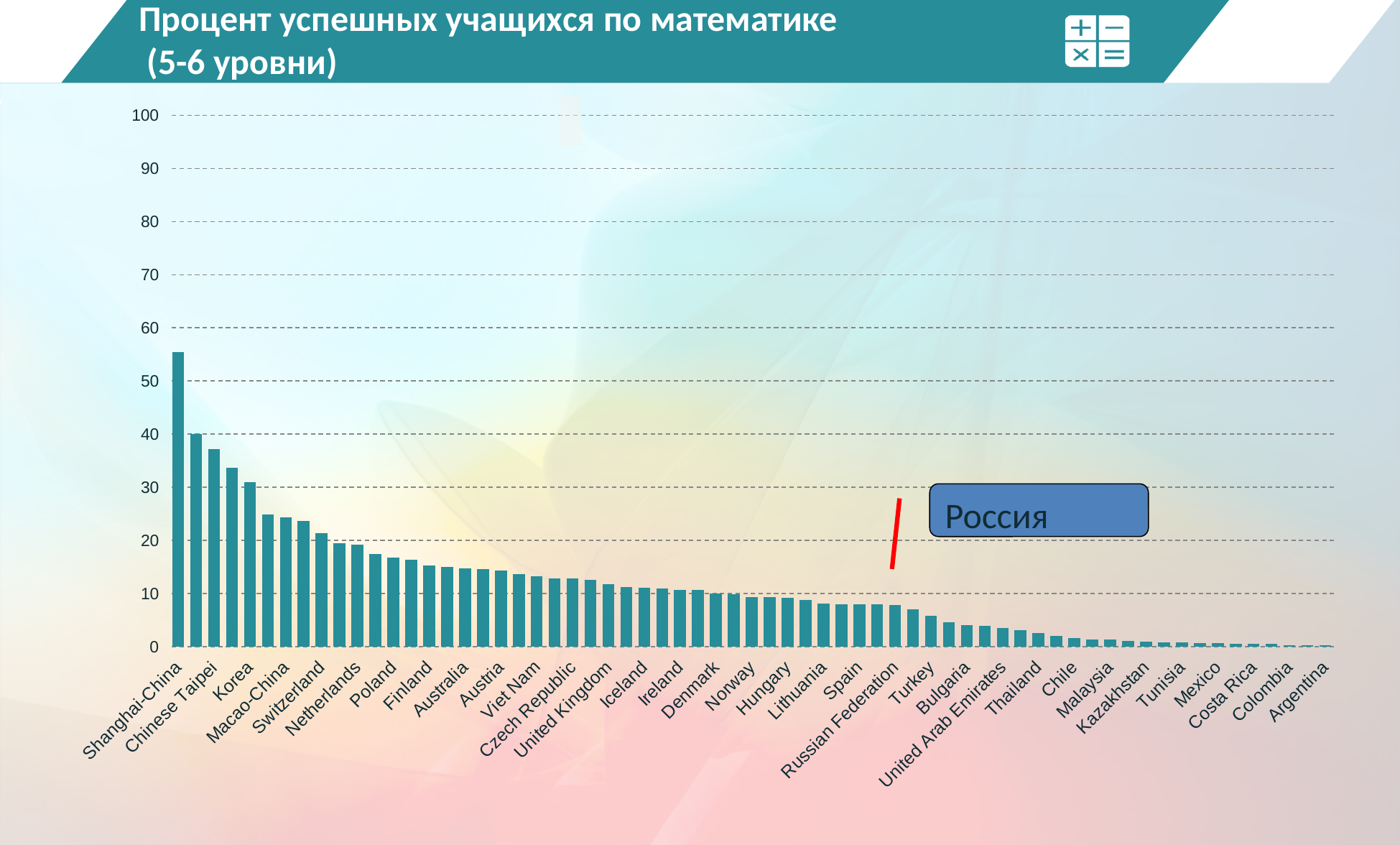
What is the title of the slide? Процент успешных учащихся по математике (5-6 уровни) Is the value for Poland greater or less than 20? less Is the value for Shanghai-China greater or less than 50? greater Is the value for Turkey greater or less than 10? less What kind of chart is shown on the slide? bar chart Which is larger, the value for Shanghai-China or the value for Korea? Shanghai-China Which country has the highest percentage of successful students in mathematics? Shanghai-China Which is larger, the value for Poland or the value for Bulgaria? Poland Do the values rise or fall moving from left to right along the x axis? fall